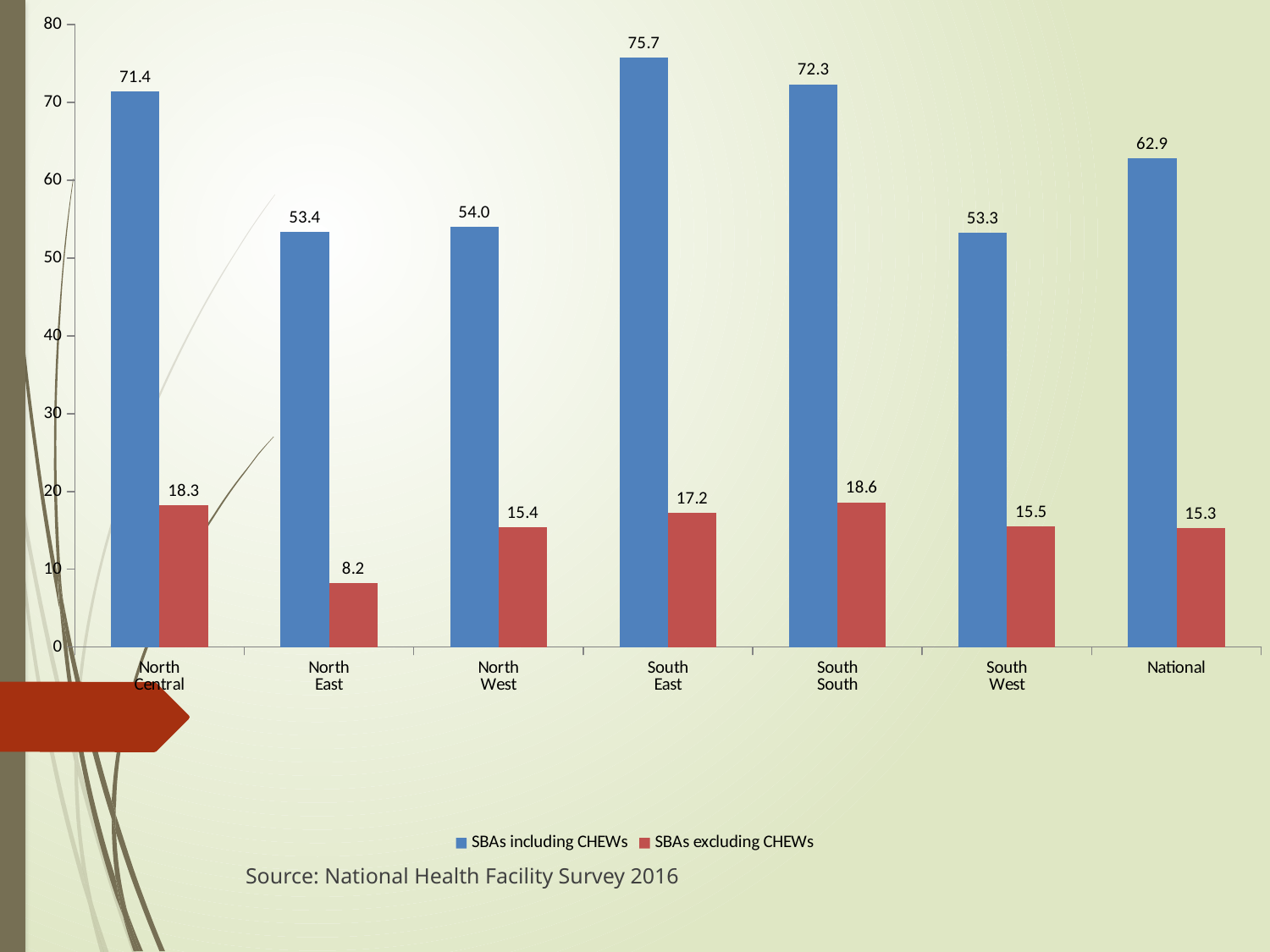
What is the difference between SBAs including CHEWs and SBAs excluding CHEWs in North Central? 53.1 How many series does the legend list? 2 What is the value for SBAs including CHEWs in South East? 75.7 How many categories are shown on the x axis? 7 What is the National value for SBAs including CHEWs? 62.9 What kind of chart is shown on the slide? Bar chart What is the source cited below the chart? National Health Facility Survey 2016 Which category has the lowest value for SBAs excluding CHEWs? North East Which is larger: SBAs excluding CHEWs in South South or in South West? South South Which colour represents SBAs excluding CHEWs in the legend? Red Which category has the highest value for SBAs including CHEWs? South East What is the value for SBAs excluding CHEWs in North East? 8.2